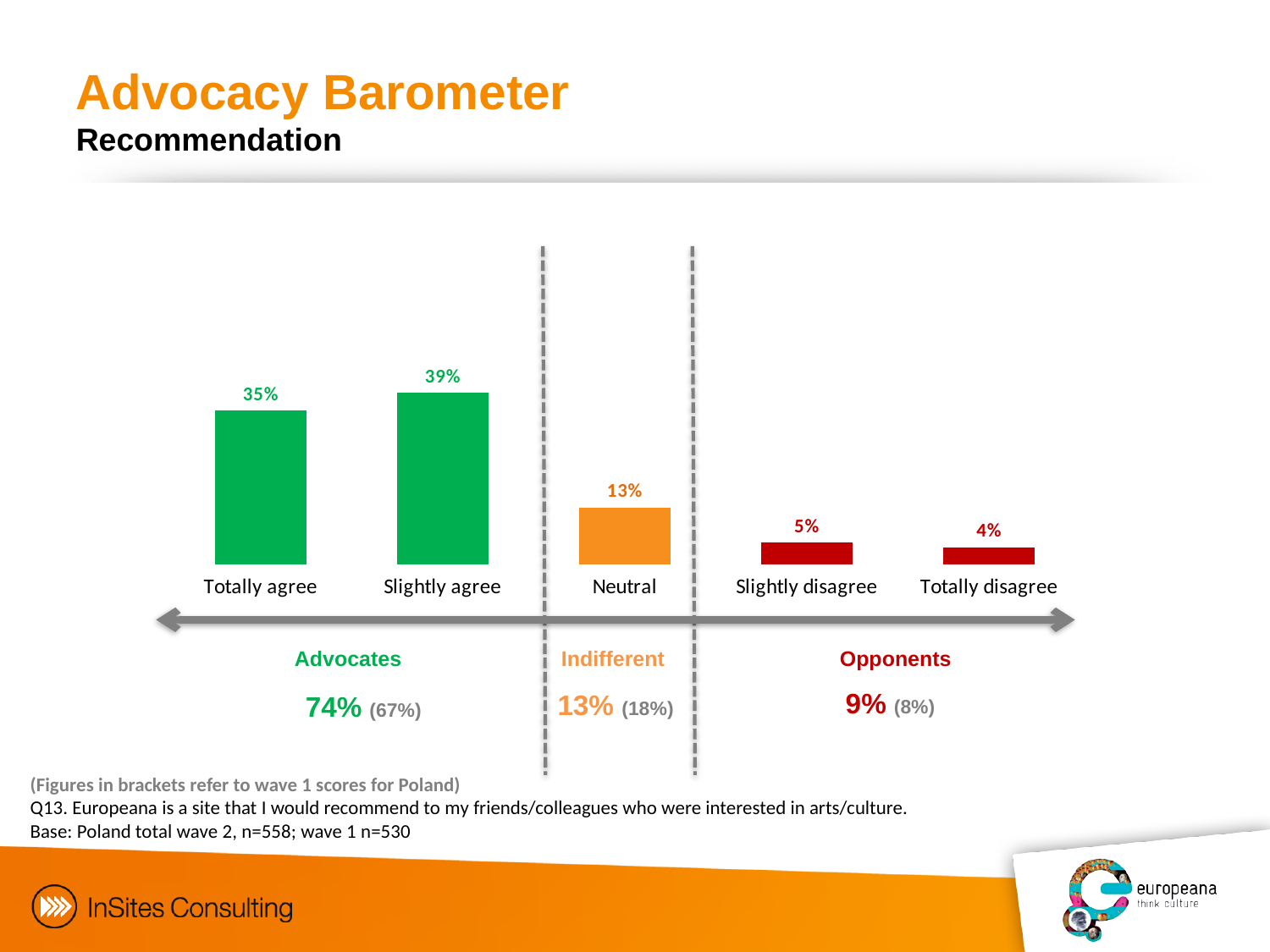
What is the value for Totally disagree? 4% What colour are the bars for Slightly disagree and Totally disagree? Red How many categories are shown in the chart? 5 What is the difference between the values for Slightly agree and Totally agree? 4% What is the value for Neutral? 13% What is the value for Totally agree? 35% Which category has the highest value? Slightly agree Which is larger, the value for Neutral or the value for Slightly disagree? Neutral What is the value for Slightly agree? 39% What kind of chart is shown on the slide? Bar chart What is the combined share of Advocates shown below the chart? 74% Which category has the lowest value? Totally disagree